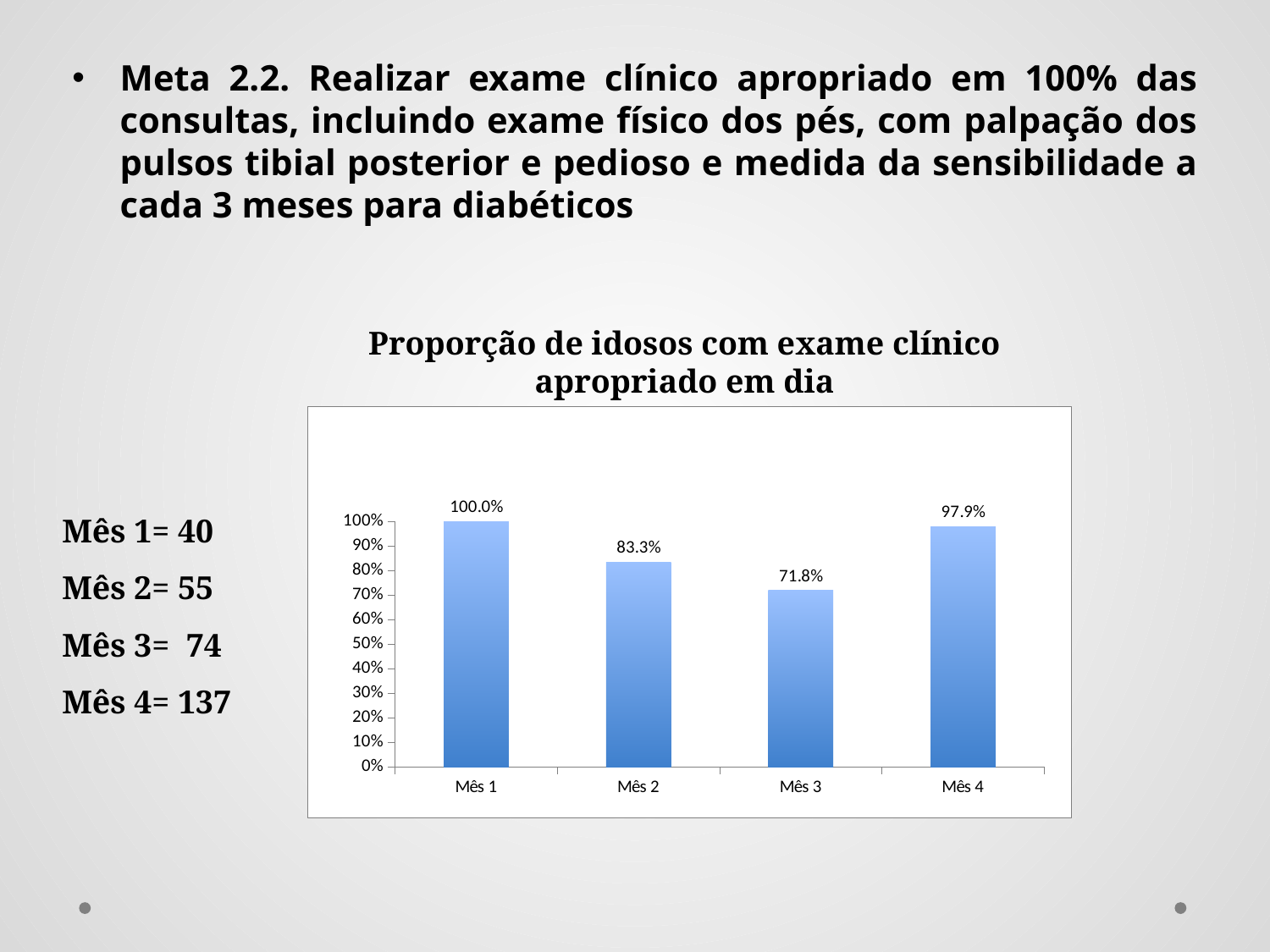
Which is larger, the value for Mês 2 or the value for Mês 4? Mês 4 Which month has the highest value? Mês 1 What is the value for Mês 1? 100.0% What kind of chart is shown on the slide? Bar chart What is the title of the chart? Proporção de idosos com exame clínico apropriado em dia What is the value for Mês 4? 97.9% What is the difference between the values for Mês 1 and Mês 3? 28.2% Which month has the lowest value? Mês 3 What is the difference between the values for Mês 4 and Mês 2? 14.6% What is the value for Mês 2? 83.3% How many months are shown on the x axis? 4 What is the value for Mês 3? 71.8%